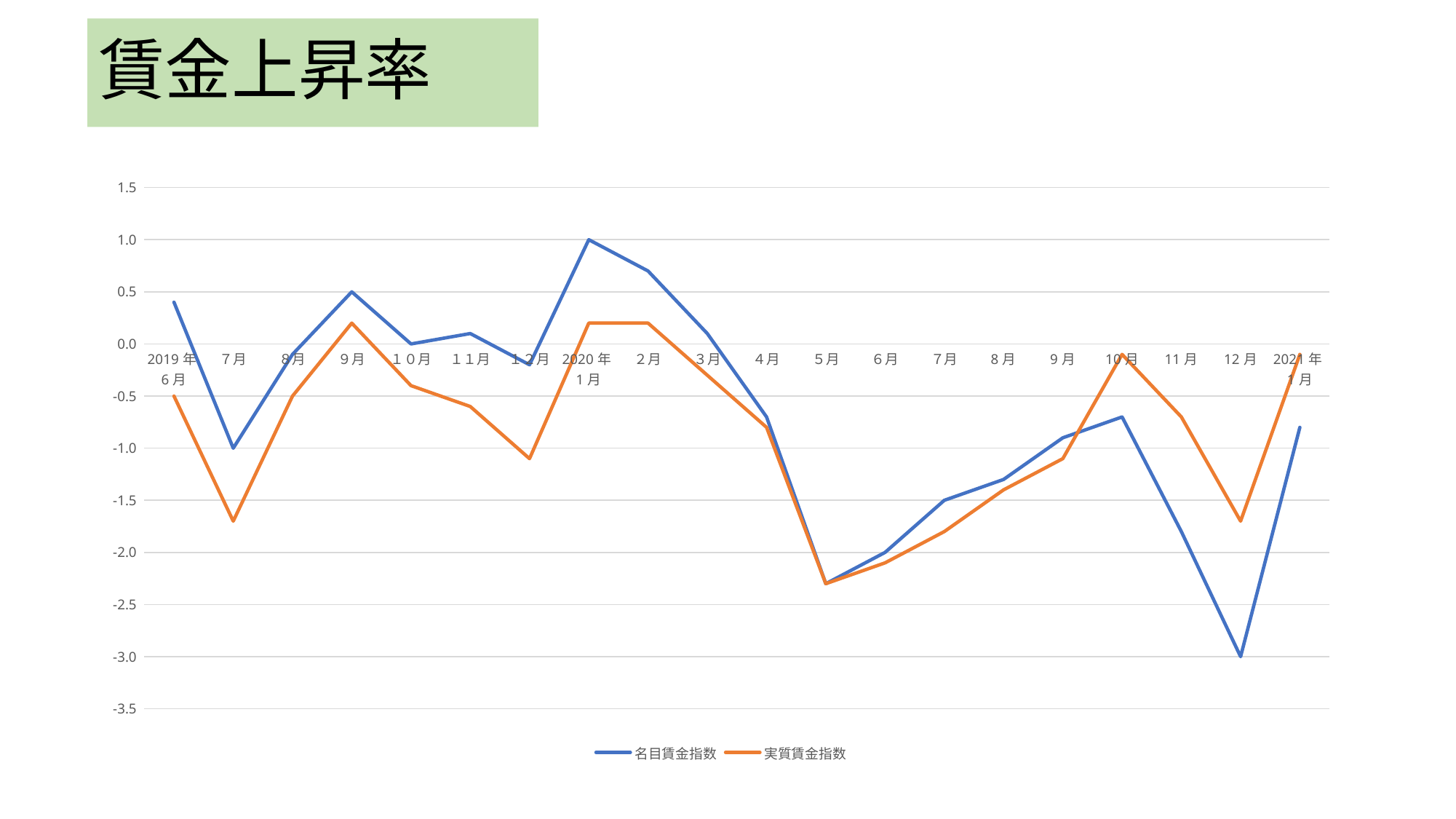
How many series does the legend list? 2 In which month does 名目賃金指数 reach its highest value? 2020年1月 What colour is the line for 名目賃金指数? blue What kind of chart is shown on the slide? line chart What is the value of 名目賃金指数 at 2019年7月? -1.0 What is the value of 名目賃金指数 at 2020年1月? 1.0 In which month does 名目賃金指数 reach its lowest value? 2020年12月 How many months (points) are plotted along the x axis? 20 Is the value of 実質賃金指数 at 2019年7月 greater or less than -1.5? less In which month does 実質賃金指数 reach its lowest value? 2020年5月 At 2020年12月, which series has the higher value, 名目賃金指数 or 実質賃金指数? 実質賃金指数 What is the value of 名目賃金指数 at 2020年12月? -3.0